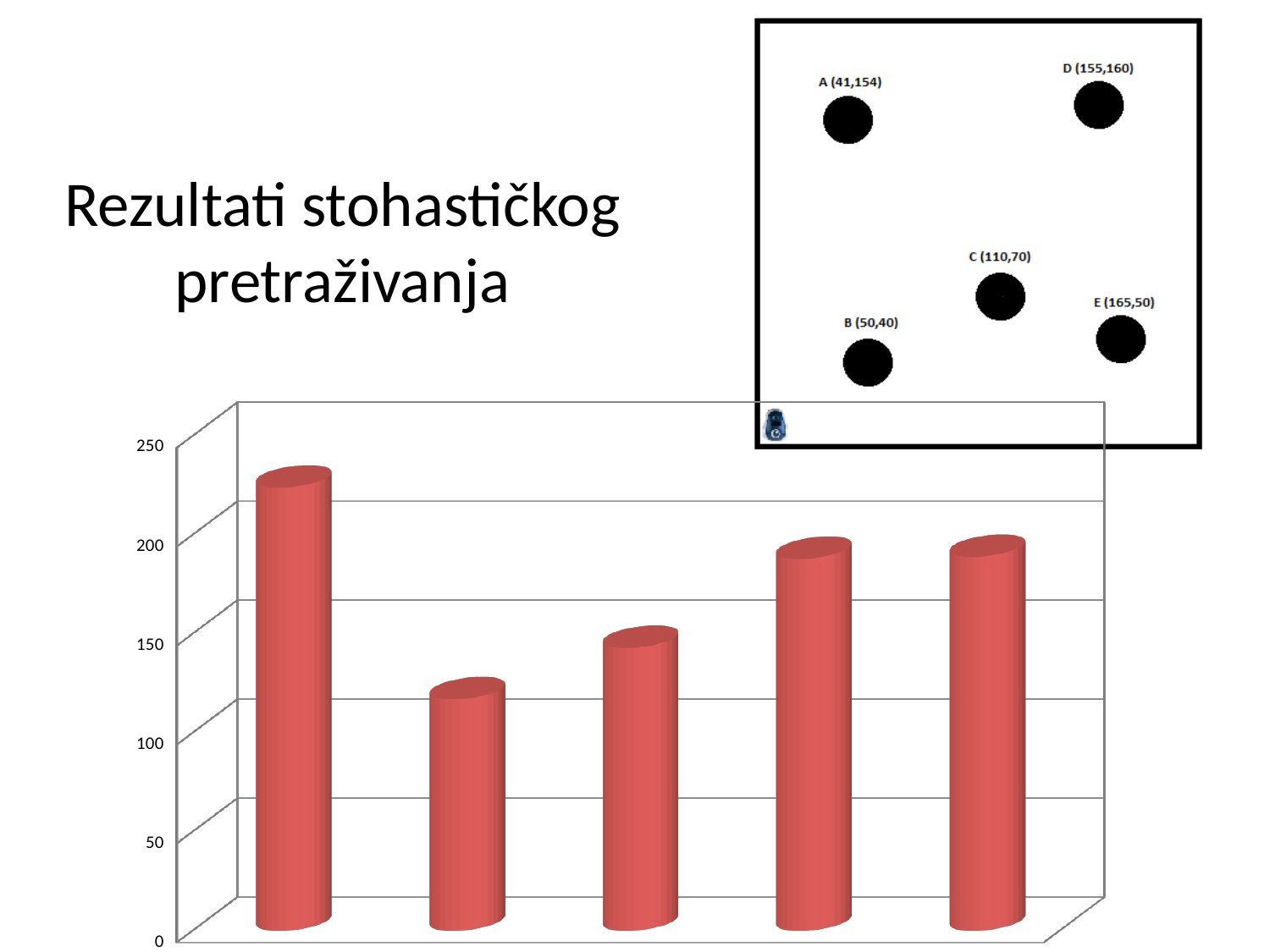
What is the highest value shown on the vertical axis of the bar chart? 250 Which bar in the bar chart is the tallest? the first bar (leftmost) Which is larger, the first bar or the second bar? the first bar Is the value of the second bar greater or less than 100? greater Is the value of the second bar greater or less than 150? less How many bars does the bar chart contain? 5 Which is larger, the third bar or the fourth bar? the fourth bar Which bar in the bar chart is the shortest? the second bar Is the value of the fourth bar greater or less than 150? greater What kind of chart is shown on the slide? bar chart